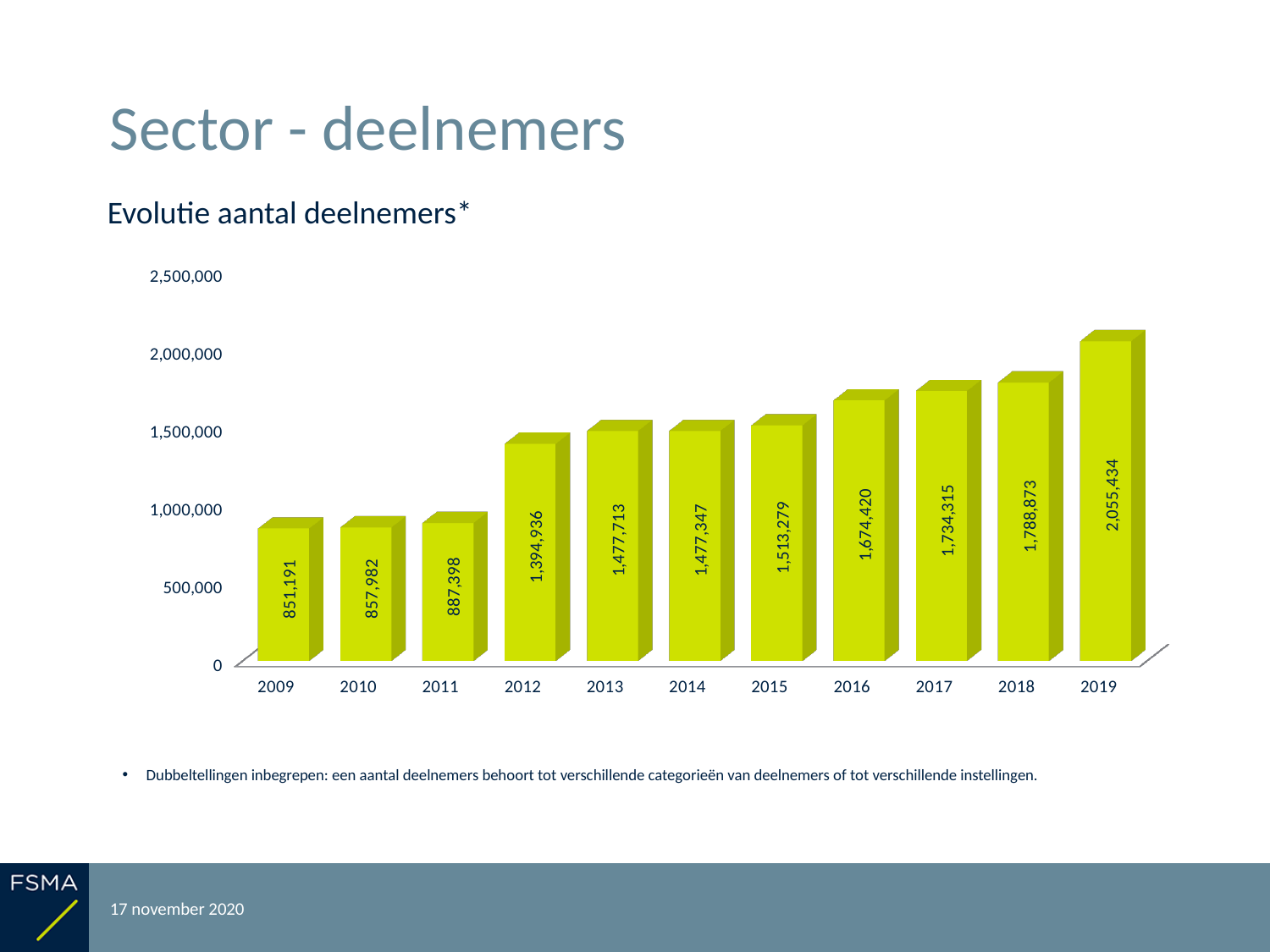
What is the value for 2015? 1,513,279 What kind of chart is shown on the slide? bar chart What is the difference between the values for 2019 and 2018? 266,561 Which year has the highest value? 2019 How many years are shown on the x axis? 11 What is the value for 2019? 2,055,434 Do the values generally rise or fall from 2009 to 2019? rise What is the difference between the values for 2012 and 2011? 507,538 Which year has the lowest value? 2009 What is the value for 2009? 851,191 Which is larger, the value for 2016 or the value for 2012? 2016 Is the value for 2016 greater or less than 1,500,000? greater